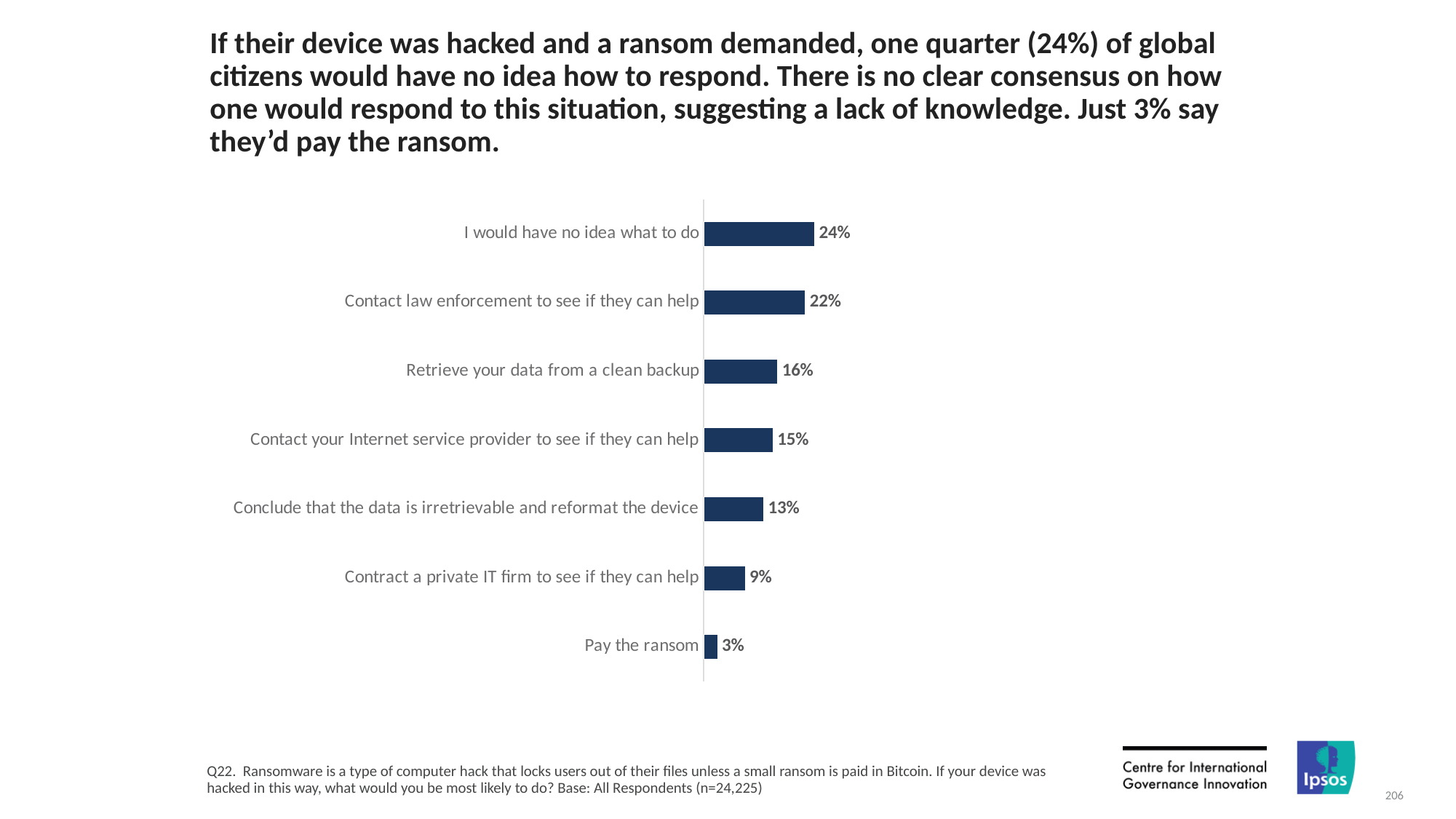
What is the difference in percentage points between 'Contact law enforcement to see if they can help' and 'Contract a private IT firm to see if they can help'? 13 What percentage of respondents would retrieve their data from a clean backup? 16% Which response has the lowest percentage? Pay the ransom Which response has the highest percentage? I would have no idea what to do How many response categories are shown in the chart? 7 What is the difference in percentage points between 'I would have no idea what to do' and 'Pay the ransom'? 21 What is the base size (n) stated for the question in the chart footnote? 24,225 Which is larger: the value for 'Contact your Internet service provider to see if they can help' or 'Conclude that the data is irretrievable and reformat the device'? Contact your Internet service provider to see if they can help What kind of chart is shown on the slide? Bar chart What percentage of respondents said they would have no idea what to do? 24% What percentage of respondents would pay the ransom? 3% What percentage of respondents would contact law enforcement to see if they can help? 22%